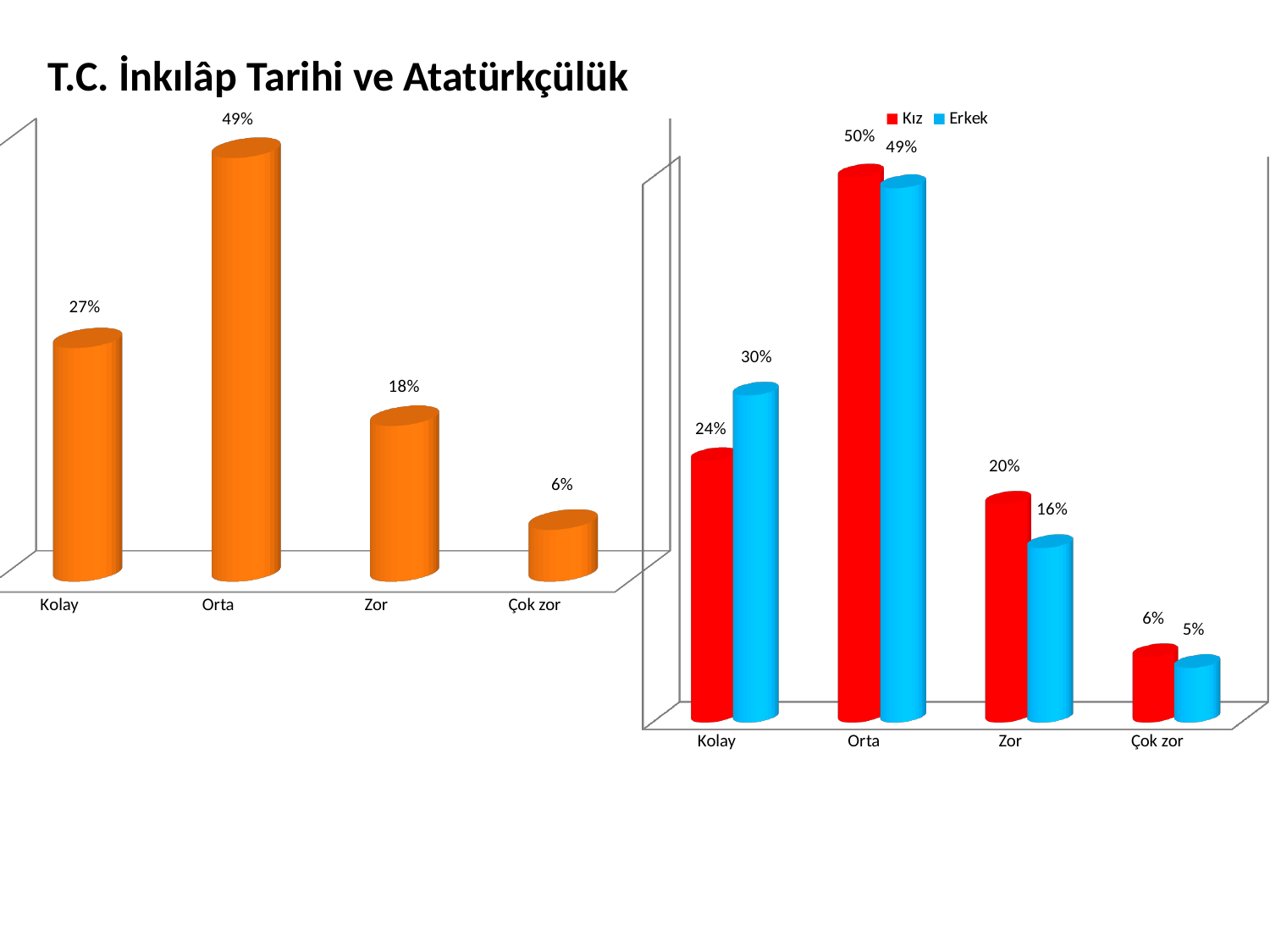
In the left chart, which category has the lowest value? Çok zor In the left chart, what is the value for Çok zor? 6% In the right chart, what is the Erkek value for Kolay? 30% What kind of chart is the right chart? Bar chart In the right chart, which is larger for Kolay: Kız or Erkek? Erkek In the left chart, which category has the highest value? Orta In the right chart, what is the difference between the Kız and Erkek values for Zor? 4% In the left chart, what is the value for Orta? 49% In the right chart, what is the Kız value for Zor? 20% In the left chart, what is the difference between the values for Kolay and Zor? 9% In the left chart, how many categories are shown on the x axis? 4 How many series does the legend of the right chart list? 2